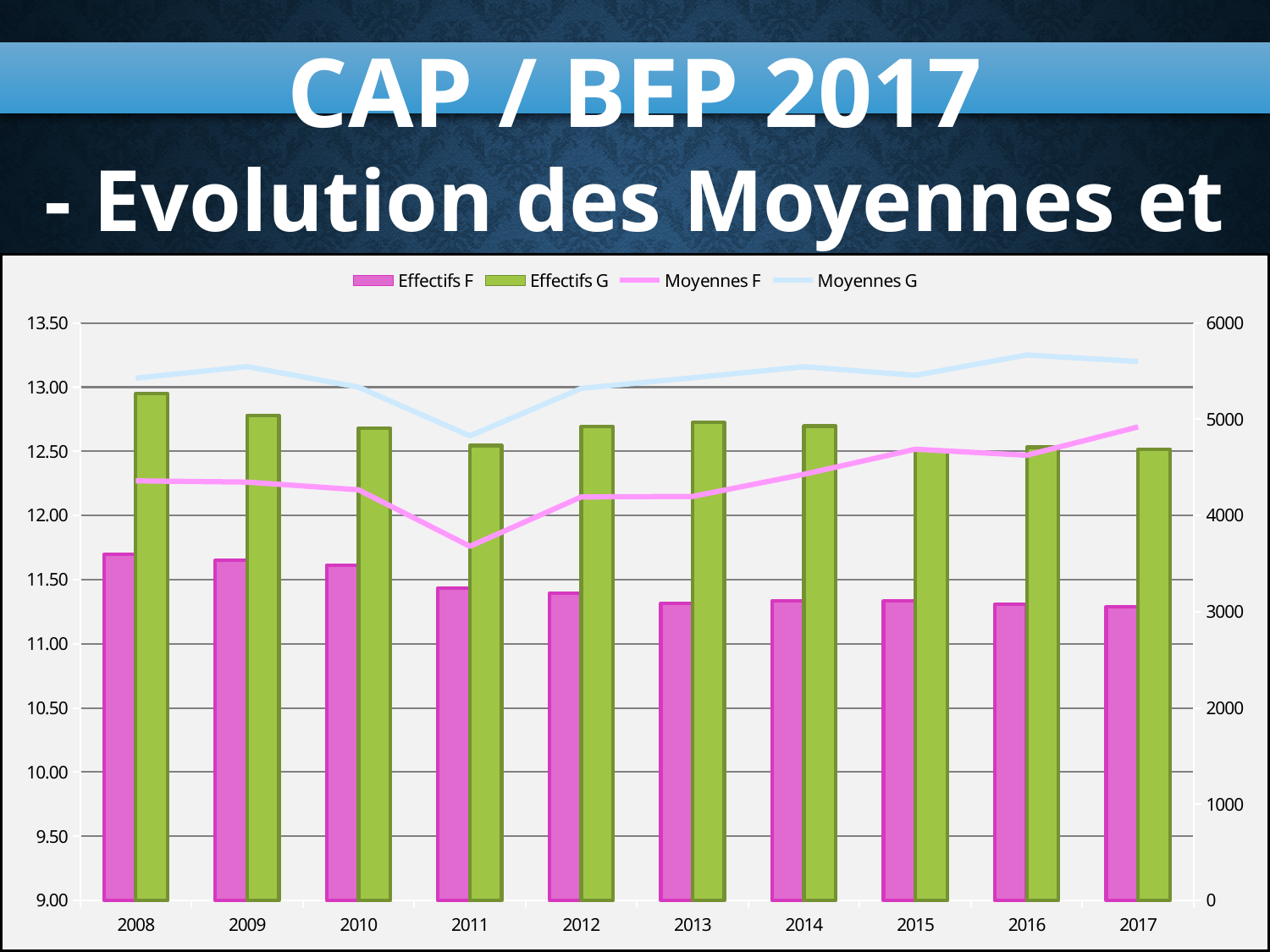
In which year is the Moyennes F line at its highest? 2017 How many years are shown on the x axis? 10 In which year is the Effectifs G bar highest? 2008 Is the Effectifs G value for 2008 greater or less than 5000 on the right axis? greater In which year is the Effectifs F bar highest? 2008 What kind of chart is this? A combined bar and line chart In which year is the Moyennes G line at its lowest? 2011 In which year is the Moyennes F line at its lowest? 2011 Does the Moyennes F line rise or fall from 2011 to 2017? rise In 2008, which bar is taller: Effectifs F or Effectifs G? Effectifs G How many series does the legend list? 4 Is the Moyennes F value for 2011 greater or less than 12.00 on the left axis? less